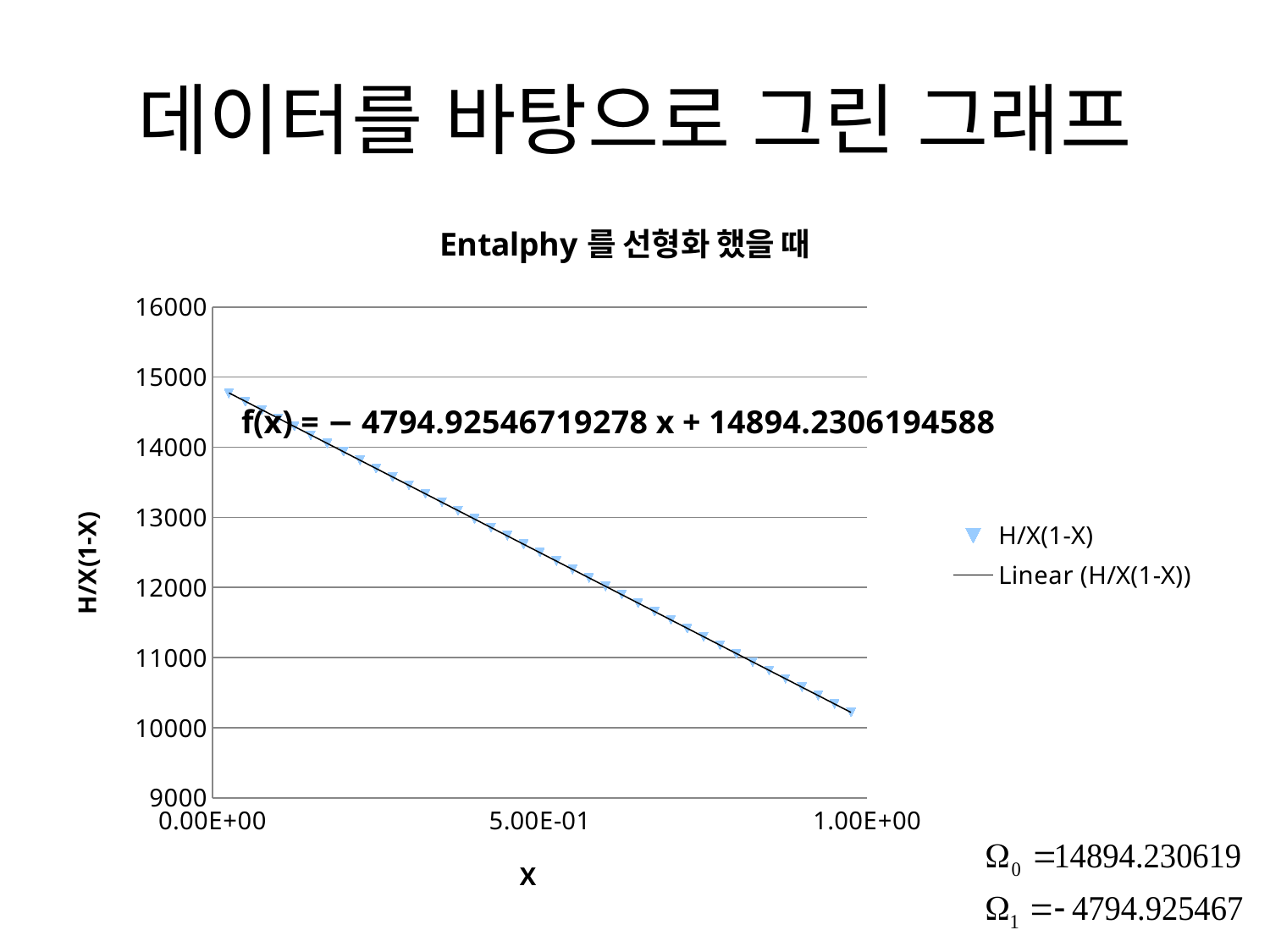
Is the H/X(1-X) value at X = 1.00E+00 greater or less than 11000? less What is the label of the y axis? H/X(1-X) What is the intercept of the fitted line shown in the trendline equation? 14894.2306194588 What is the slope of the fitted line shown in the trendline equation? −4794.92546719278 What is the title of the chart? Entalphy 를 선형화 했을 때 What kind of chart is shown on the slide? scatter chart Do the H/X(1-X) values rise or fall as X increases? fall Is the H/X(1-X) value at X = 0.00E+00 greater or less than 14000? greater Which is larger, the H/X(1-X) value at X = 0.00E+00 or at X = 1.00E+00? X = 0.00E+00 How many series does the chart legend list? 2 Is the H/X(1-X) value at X = 5.00E-01 greater or less than 13000? less